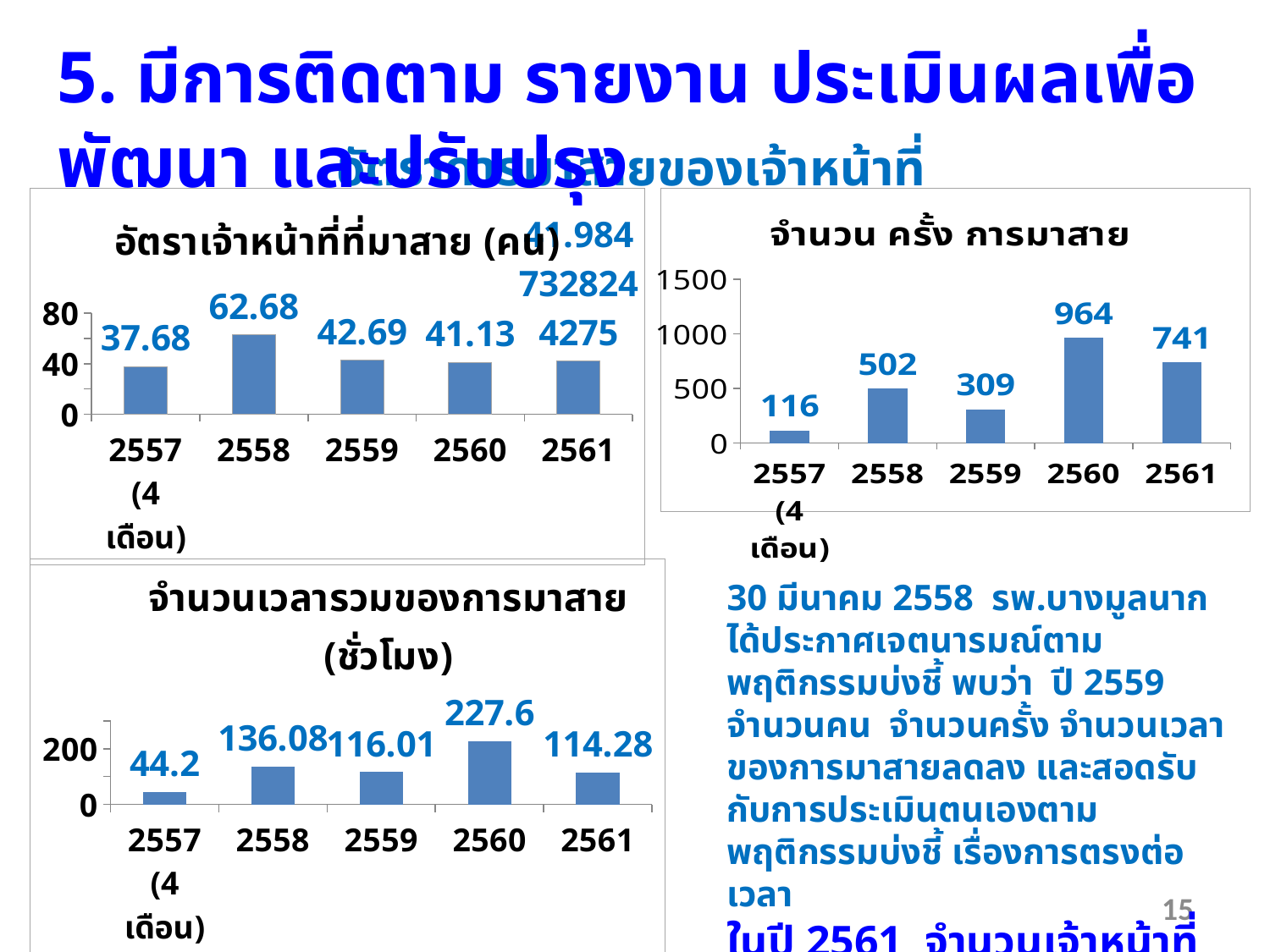
In the chart titled "อัตราเจ้าหน้าที่ที่มาสาย (คน)" (top left), which year has the highest value? 2558 What kind of chart is the chart titled "จำนวน ครั้ง การมาสาย" (top right)? bar chart In the chart titled "จำนวน ครั้ง การมาสาย" (top right), what is the value for 2560? 964 In the chart titled "จำนวน ครั้ง การมาสาย" (top right), which year has the lowest value? 2557 (4 เดือน) In the chart titled "อัตราเจ้าหน้าที่ที่มาสาย (คน)" (top left), which is larger, the value for 2557 (4 เดือน) or the value for 2559? 2559 In the chart titled "จำนวน ครั้ง การมาสาย" (top right), what is the difference between the values for 2560 and 2561? 223 In the chart titled "จำนวน ครั้ง การมาสาย" (top right), is the value for 2559 greater or less than 500? less In the chart titled "จำนวนเวลารวมของการมาสาย (ชั่วโมง)" (bottom left), what is the value for 2560? 227.6 In the chart titled "อัตราเจ้าหน้าที่ที่มาสาย (คน)" (top left), what is the value for 2558? 62.68 In the chart titled "จำนวนเวลารวมของการมาสาย (ชั่วโมง)" (bottom left), how many years are plotted? 5 In the chart titled "จำนวนเวลารวมของการมาสาย (ชั่วโมง)" (bottom left), what is the value for 2557 (4 เดือน)? 44.2 In the chart titled "จำนวน ครั้ง การมาสาย" (top right), what is the value for 2558? 502